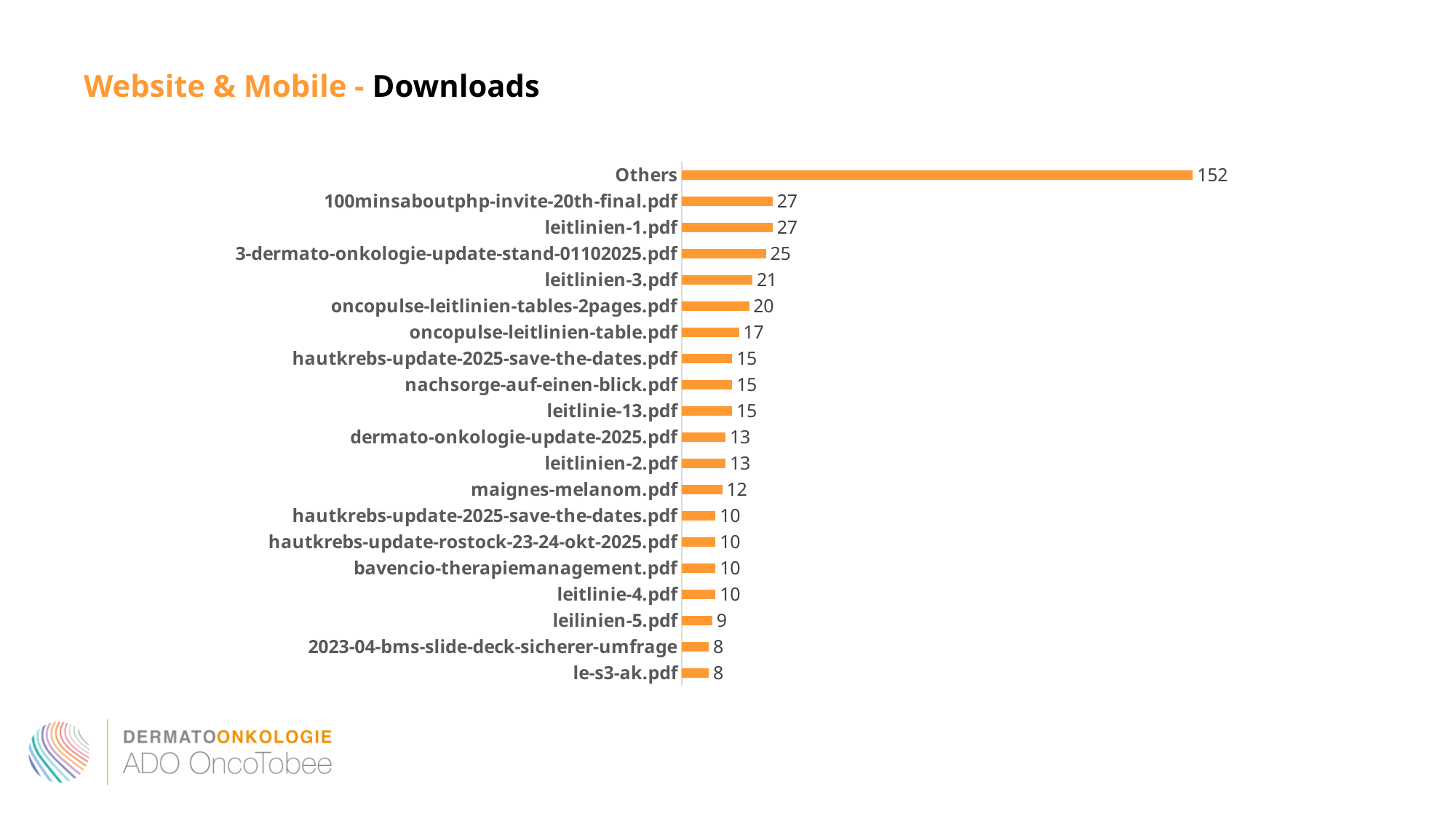
Which category has the highest value? Others What is the title of the slide? Website & Mobile - Downloads What kind of chart is shown on the slide? bar chart What is the value for leitlinien-3.pdf? 21 What is the value for Others? 152 What is the value for oncopulse-leitlinien-table.pdf? 17 Which is larger, the value for leitlinien-2.pdf or the value for leitlinie-4.pdf? leitlinien-2.pdf What is the difference between the values for oncopulse-leitlinien-tables-2pages.pdf and leilinien-5.pdf? 11 What is the value for maignes-melanom.pdf? 12 What is the difference between the values for Others and leitlinien-1.pdf? 125 What is the value for 3-dermato-onkologie-update-stand-01102025.pdf? 25 How many categories are shown in the chart? 20